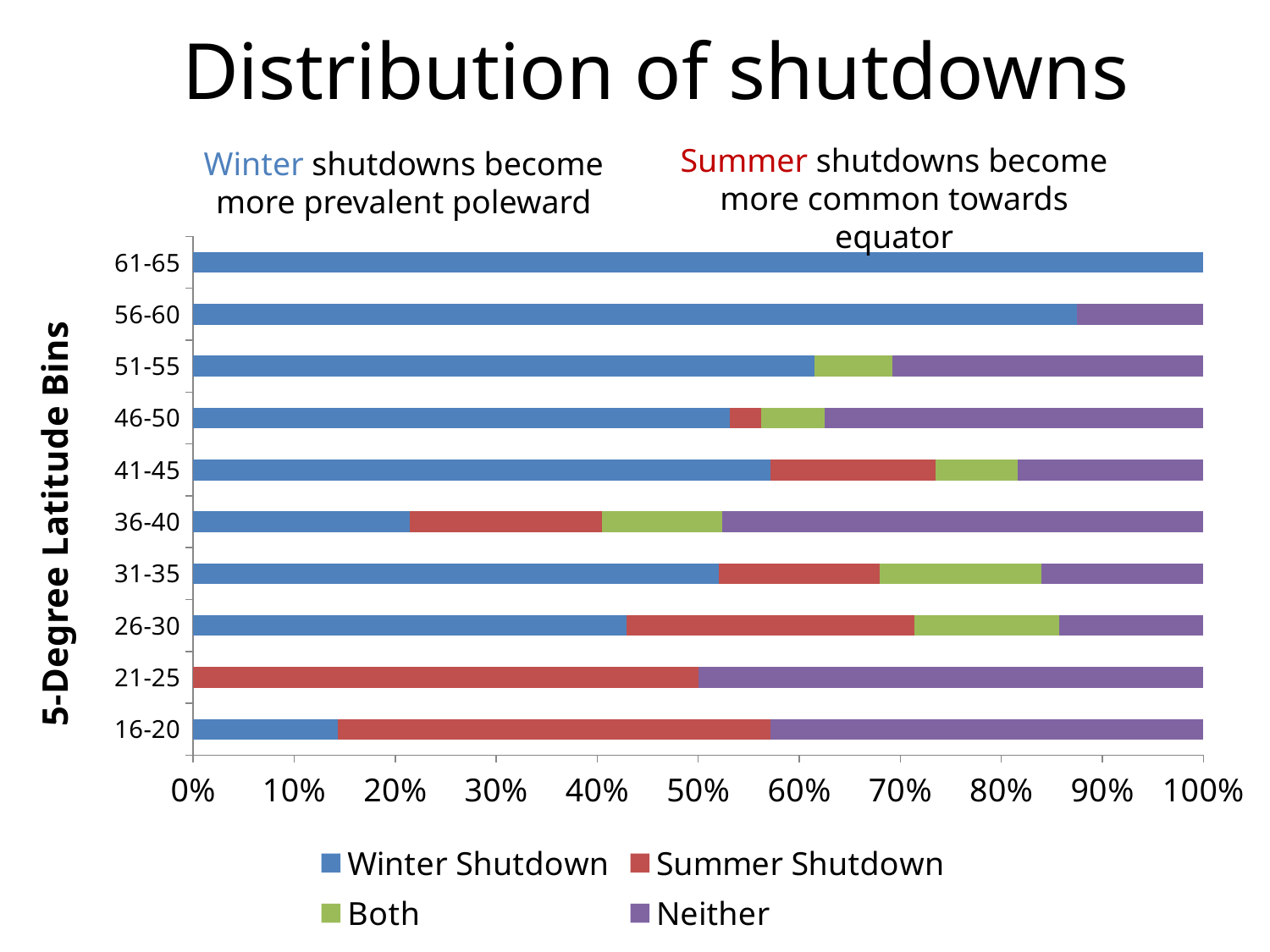
Which bin has a larger Winter Shutdown share, 31-35 or 36-40? 31-35 Which latitude bin has the smallest Winter Shutdown share? 21-25 Which bin has a larger Summer Shutdown share, 21-25 or 26-30? 21-25 Which latitude bin has the largest Winter Shutdown share? 61-65 Is the Winter Shutdown share for the 56-60 bin greater or less than 80%? greater Is the Winter Shutdown share for the 36-40 bin greater or less than 30%? less How many series does the legend list? 4 Is the Winter Shutdown share for the 16-20 bin greater or less than 20%? less How many latitude bins are plotted on the y axis? 10 What kind of chart is shown on the slide? bar chart What is the Winter Shutdown share for the 61-65 latitude bin? 100% What is the label of the y axis? 5-Degree Latitude Bins